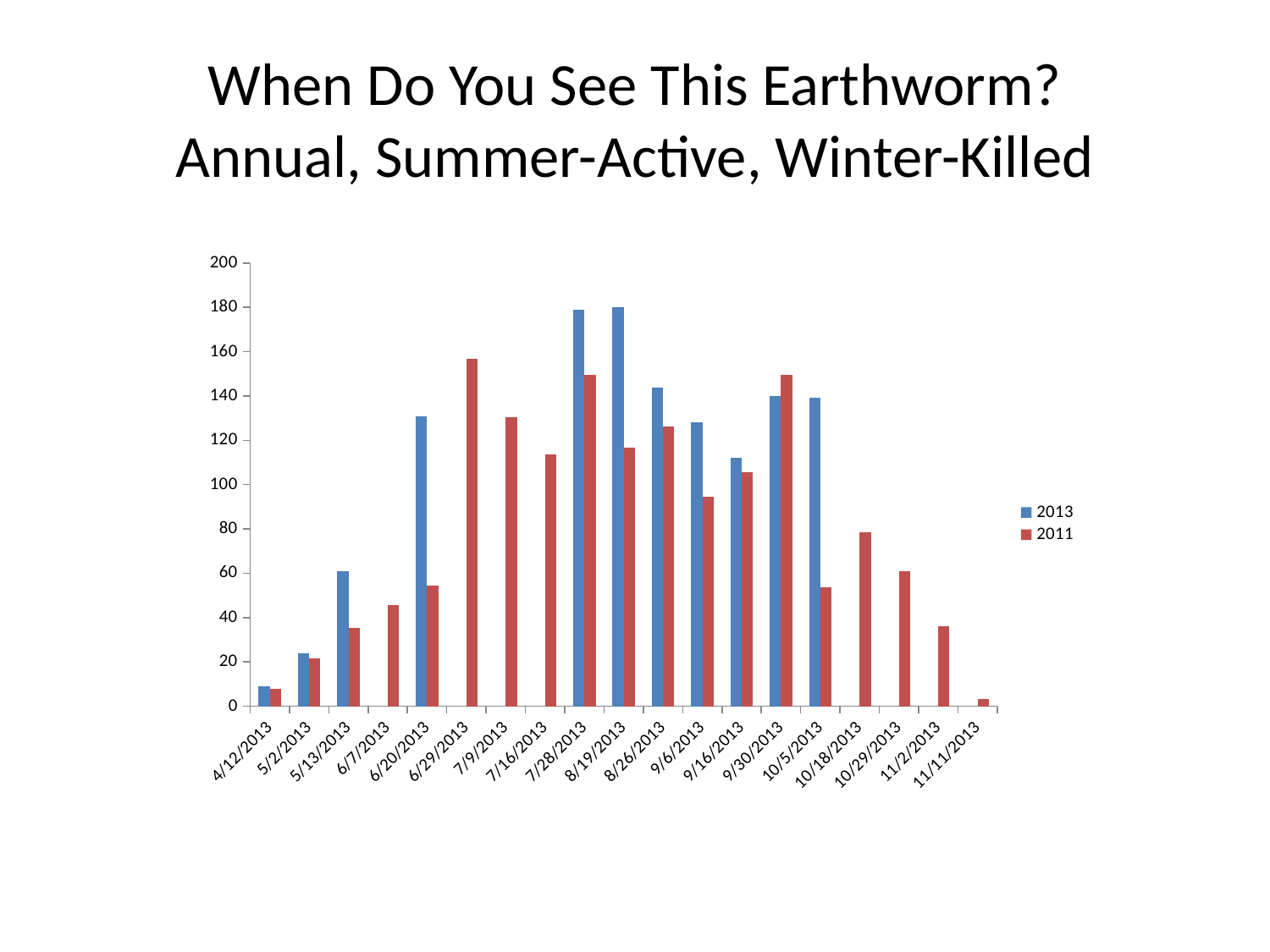
Which date has the lowest value for the 2013 series? 4/12/2013 Is the 2013 value for 5/13/2013 greater or less than 40? greater Which series is shown in blue according to the legend? 2013 How many series does the legend list? 2 For 7/28/2013, which series has the larger value, 2013 or 2011? 2013 Which date has the lowest value for the 2011 series? 11/11/2013 For 10/5/2013, which series has the larger value, 2013 or 2011? 2013 Is the 2011 value for 6/29/2013 greater or less than 140? greater Is the 2011 value for 11/2/2013 greater or less than 60? less How many date categories are shown on the x axis? 19 What kind of chart is shown on the slide? bar chart